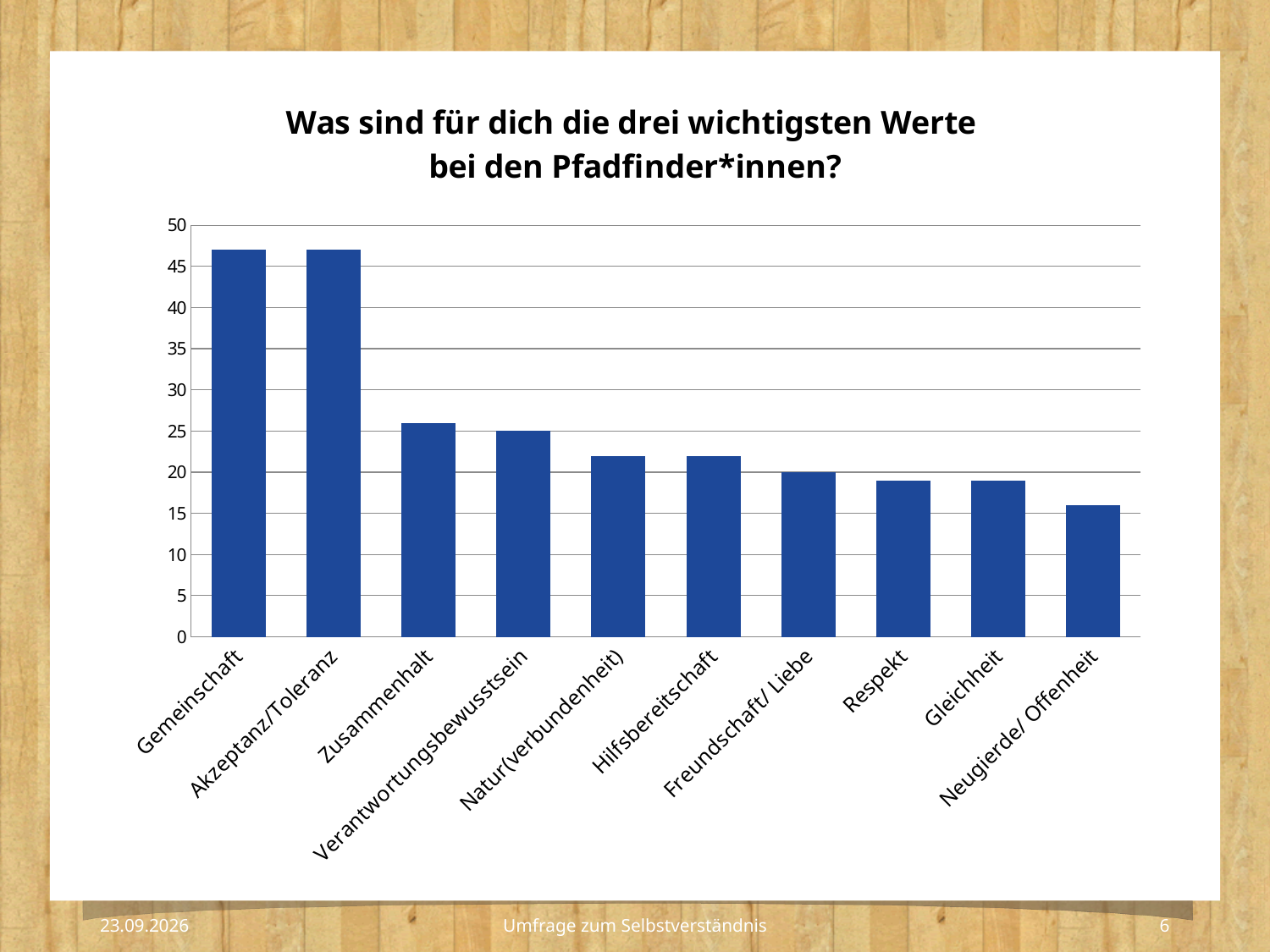
Is the value for Akzeptanz/Toleranz greater or less than 40? greater Which category has the lowest value in the chart? Neugierde/ Offenheit Is the value for Gemeinschaft greater or less than 45? greater What is the title of the chart? Was sind für dich die drei wichtigsten Werte bei den Pfadfinder*innen? Is the value for Neugierde/ Offenheit greater or less than 20? less What kind of chart is shown on the slide? bar chart Which has a larger value, Zusammenhalt or Respekt? Zusammenhalt How many categories are shown on the x axis of the chart? 10 Do the values generally rise or fall from left to right along the x axis? fall Which has a larger value, Gemeinschaft or Hilfsbereitschaft? Gemeinschaft